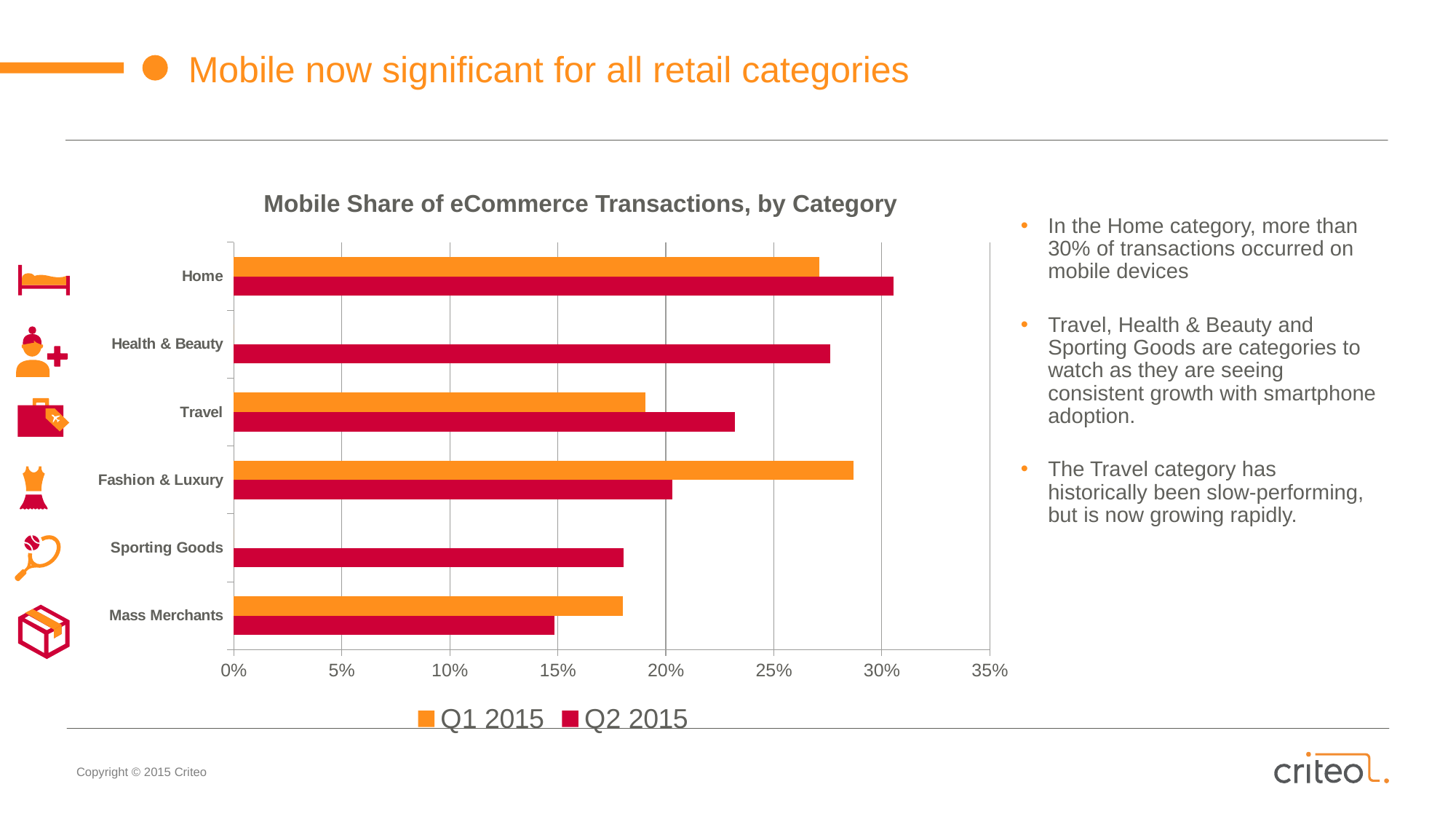
For Fashion & Luxury, which is larger: the Q1 2015 value or the Q2 2015 value? Q1 2015 Is the Q2 2015 value for Home greater or less than 30%? greater For Travel, which is larger: the Q1 2015 value or the Q2 2015 value? Q2 2015 How many series does the legend list? 2 How many categories are shown on the chart? 6 Is the Q2 2015 value for Sporting Goods greater or less than 20%? less Which category has the highest Q2 2015 value? Home Is the Q1 2015 value for Fashion & Luxury greater or less than 25%? greater What type of chart is shown on the slide? Bar chart What is the title of the chart? Mobile Share of eCommerce Transactions, by Category Which category has the lowest Q2 2015 value? Mass Merchants